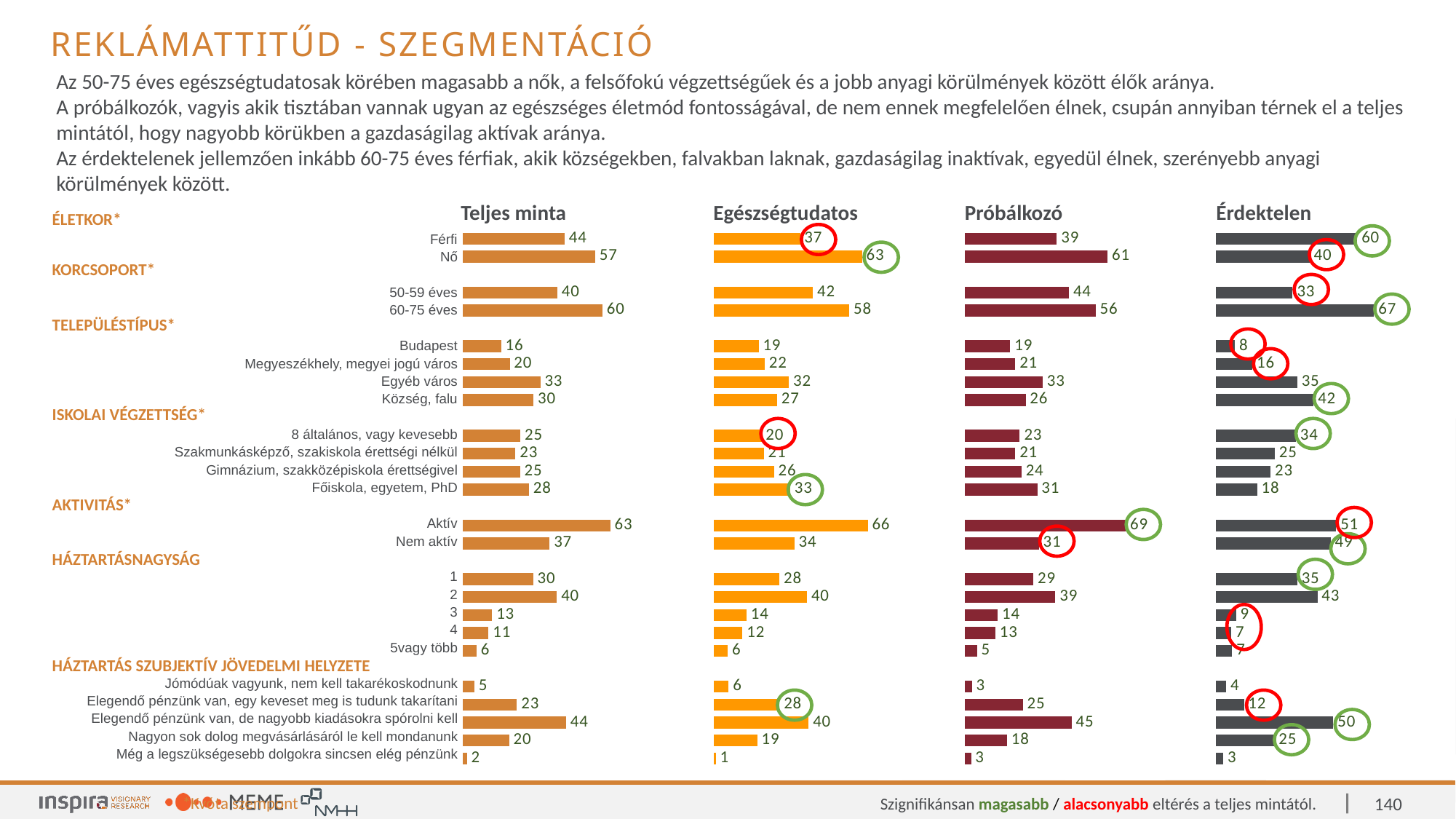
In the Érdektelen chart, which iskolai végzettség category has the lowest value? Főiskola, egyetem, PhD In the Teljes minta chart, what is the value for Nő? 57 In the Próbálkozó chart, what is the value for Budapest? 19 In the Érdektelen chart, what is the value for 60-75 éves? 67 In the Egészségtudatos chart, what is the value for Főiskola, egyetem, PhD? 33 What colour are the bars in the Érdektelen chart? Dark grey In the Próbálkozó chart, what is the difference between Aktív and Nem aktív? 38 In the Érdektelen chart, which is larger, Férfi or Nő? Férfi What kind of chart is used for the Teljes minta data? Bar chart How many categories are listed under Háztartás szubjektív jövedelmi helyzete? 5 In the Egészségtudatos chart, which településtípus category has the highest value? Egyéb város In the Teljes minta chart, how much higher is 60-75 éves than 50-59 éves? 20